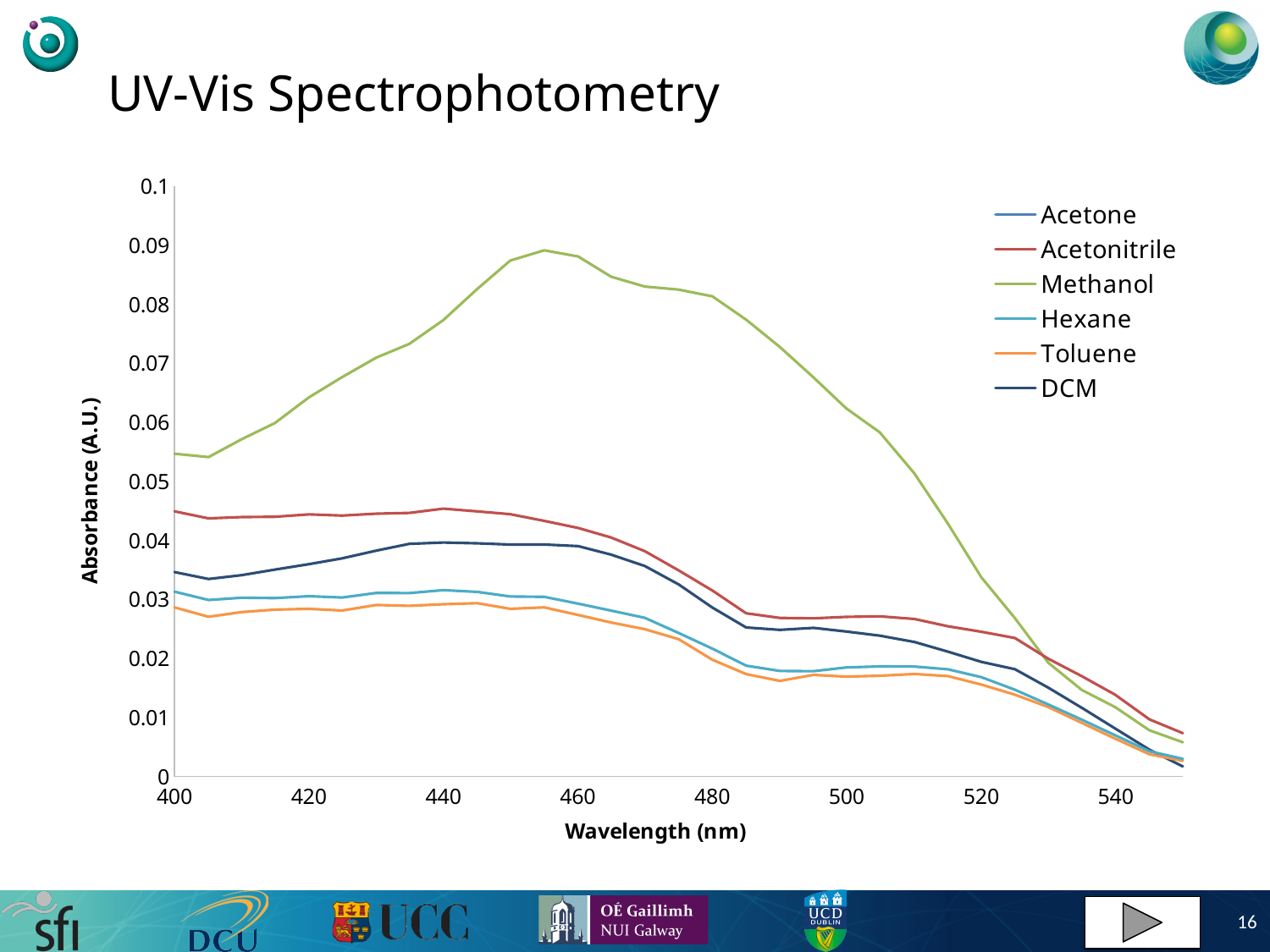
Is the absorbance of Methanol at 440 nm greater or less than 0.07? greater What is the label of the y axis? Absorbance (A.U.) Is the absorbance of DCM at 400 nm greater or less than 0.04? less Which series has the larger absorbance at 440 nm, Methanol or Toluene? Methanol Is the peak absorbance of Methanol greater or less than 0.08? greater Do the absorbance values of all series rise or fall between 480 nm and 550 nm? Fall Which series has the highest absorbance across the plotted wavelength range? Methanol What kind of chart is shown on the slide? Line chart Which series has the larger absorbance at 460 nm, Acetonitrile or DCM? Acetonitrile Does the Methanol absorbance rise or fall between 400 nm and 455 nm? Rise How many series does the legend list? 6